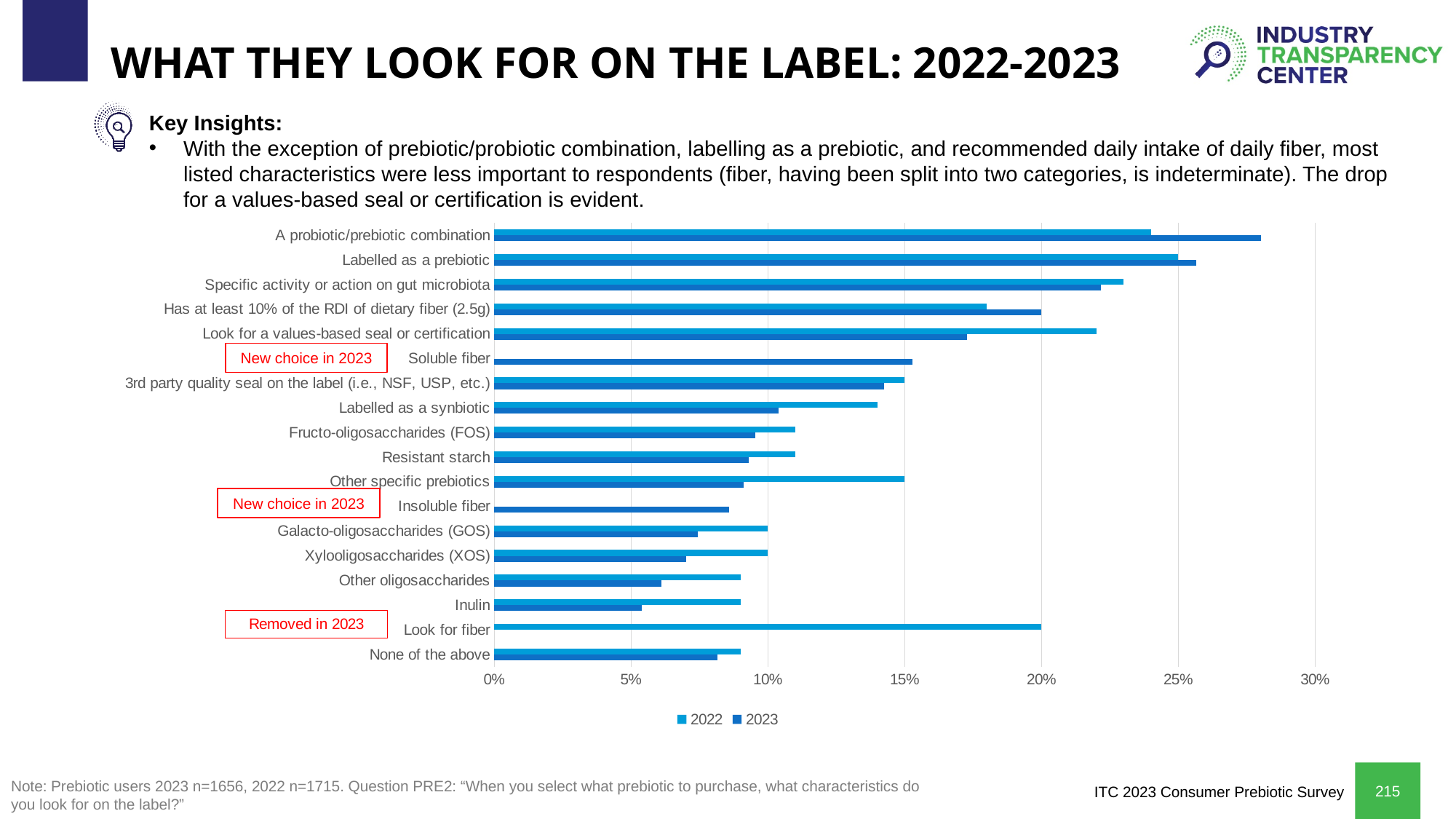
How many categories are listed on the chart's vertical axis? 18 Is the 2023 value for Inulin greater or less than 10%? less What kind of chart is shown on the slide? Bar chart For Other specific prebiotics, which year has the larger value, 2022 or 2023? 2022 Is the 2022 value for A probiotic/prebiotic combination greater or less than 25%? less Is the 2022 value for Look for fiber greater or less than 15%? greater For Look for a values-based seal or certification, which year has the larger value, 2022 or 2023? 2022 Which category has the highest 2022 value? Labelled as a prebiotic What are the two entries in the chart's legend? 2022 and 2023 Which categories are marked with the label "New choice in 2023"? Soluble fiber and Insoluble fiber How many series does the legend list? 2